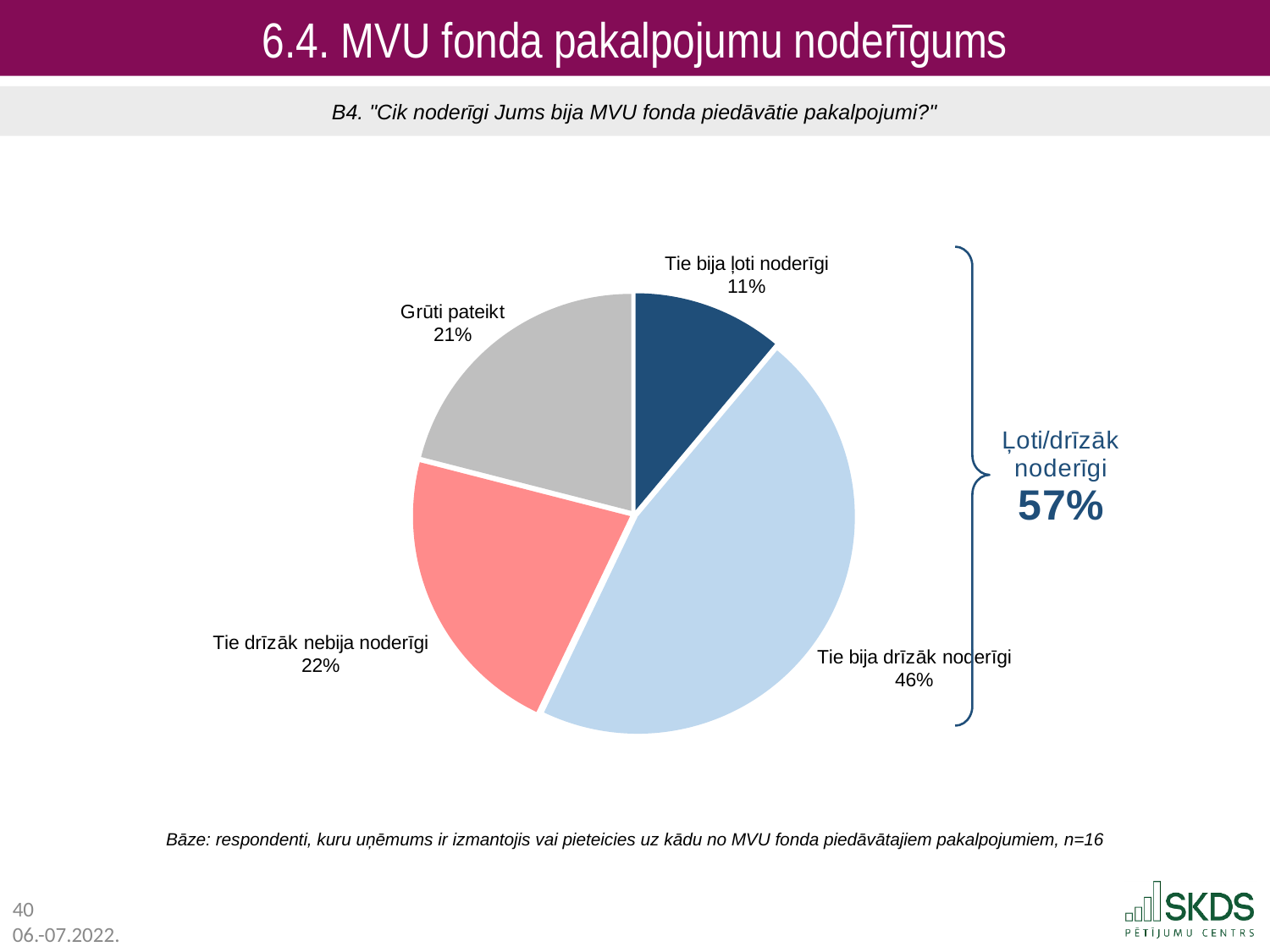
Which response category has the smallest share of the pie? Tie bija ļoti noderīgi What combined percentage is shown for "Ļoti/drīzāk noderīgi" next to the bracket? 57% What percentage of respondents answered "Tie drīzāk nebija noderīgi"? 22% What is the difference in percentage points between "Tie bija drīzāk noderīgi" and "Tie drīzāk nebija noderīgi"? 24 Which response category has the largest share of the pie? Tie bija drīzāk noderīgi What percentage of respondents answered "Tie bija drīzāk noderīgi"? 46% What type of chart is shown on the slide? pie chart What percentage of respondents answered "Tie bija ļoti noderīgi"? 11% How many slices does the pie chart have? 4 Which is larger: the share for "Grūti pateikt" or the share for "Tie bija ļoti noderīgi"? Grūti pateikt What survey question is shown above the chart? B4. "Cik noderīgi Jums bija MVU fonda piedāvātie pakalpojumi?" What percentage of respondents answered "Grūti pateikt"? 21%